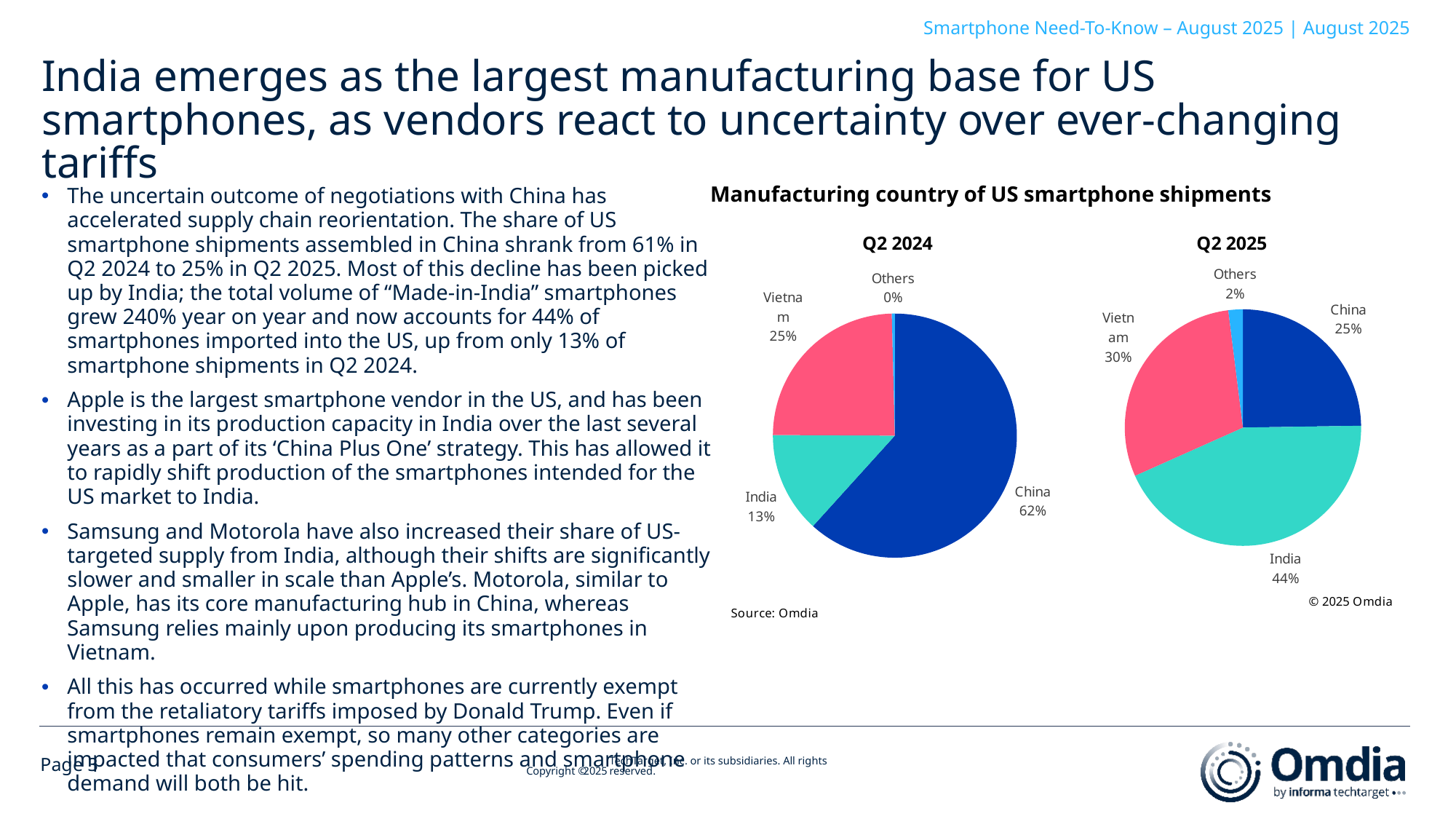
In the Q2 2025 pie chart, which is larger: the share for Vietnam or the share for China? Vietnam In the Q2 2024 pie chart, what share of US smartphone shipments was manufactured in China? 62% In the Q2 2025 pie chart, what share of US smartphone shipments was manufactured in India? 44% How many slices does the Q2 2025 pie chart have? 4 What type of chart is used to show the manufacturing country of US smartphone shipments? Pie chart In the Q2 2024 pie chart, what is the share for Others? 0% By how many percentage points did China's share fall from the Q2 2024 pie chart to the Q2 2025 pie chart? 37 percentage points What is the title of the chart area containing the two pie charts? Manufacturing country of US smartphone shipments In the Q2 2025 pie chart, what is the share for Vietnam? 30% In the Q2 2024 pie chart, which country has the largest share? China In the Q2 2025 pie chart, which country has the largest share? India In the Q2 2025 pie chart, which category has the smallest share? Others